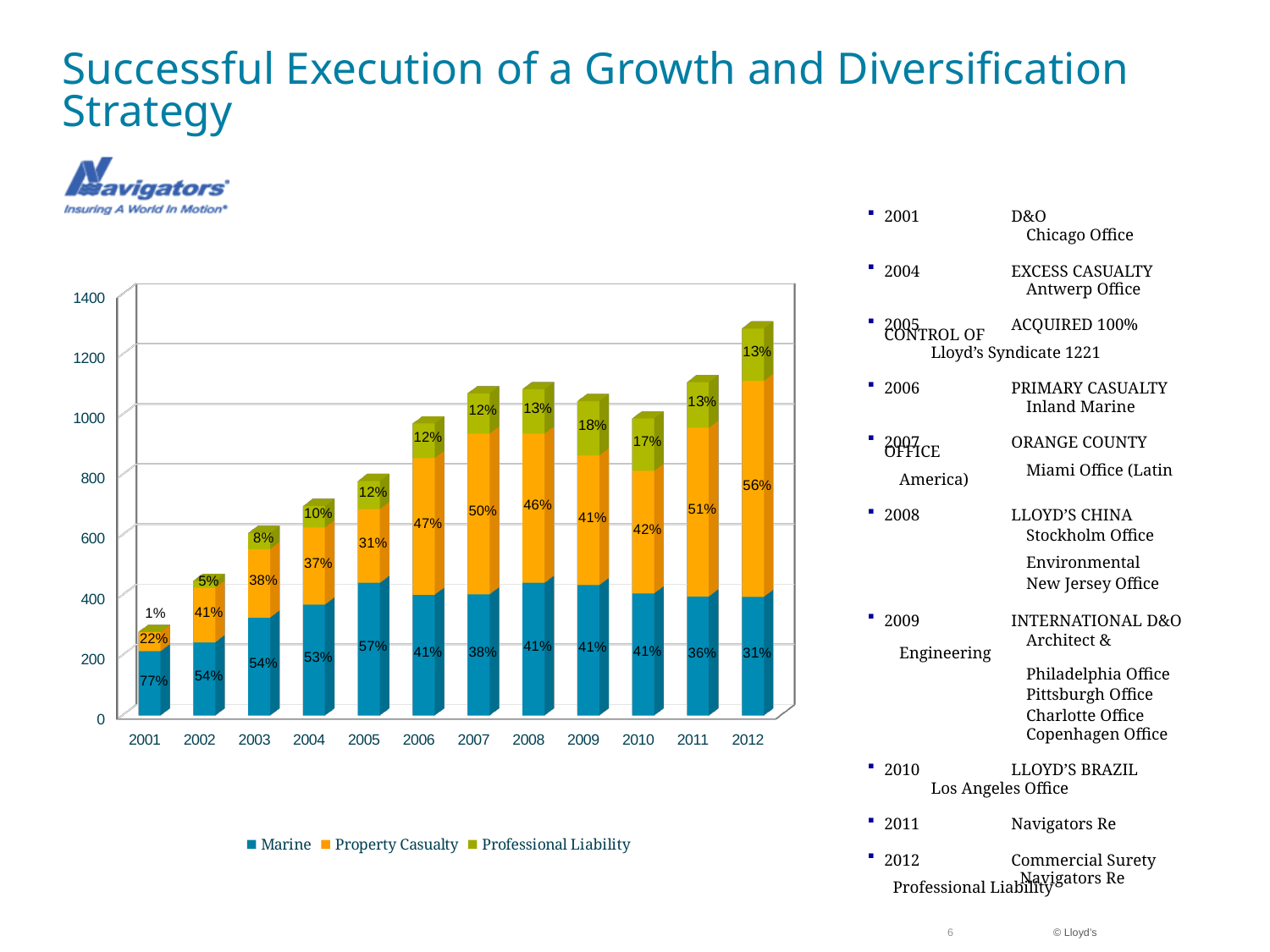
What is the Professional Liability percentage label for 2009? 18% What kind of chart is shown on the slide? Stacked bar chart Which year has the shortest total bar? 2001 Which year has the tallest total bar? 2012 What is the Marine percentage label for 2001? 77% How many series does the chart legend list? 3 Which is larger, the Marine percentage in 2001 or the Marine percentage in 2012? 2001 What is the Marine percentage label for 2005? 57% Do the total bar heights generally rise or fall from 2001 to 2012? rise Is the total bar for 2012 greater or less than 1200? greater How many years are shown along the x axis of the chart? 12 What is the Property Casualty percentage label for 2012? 56%